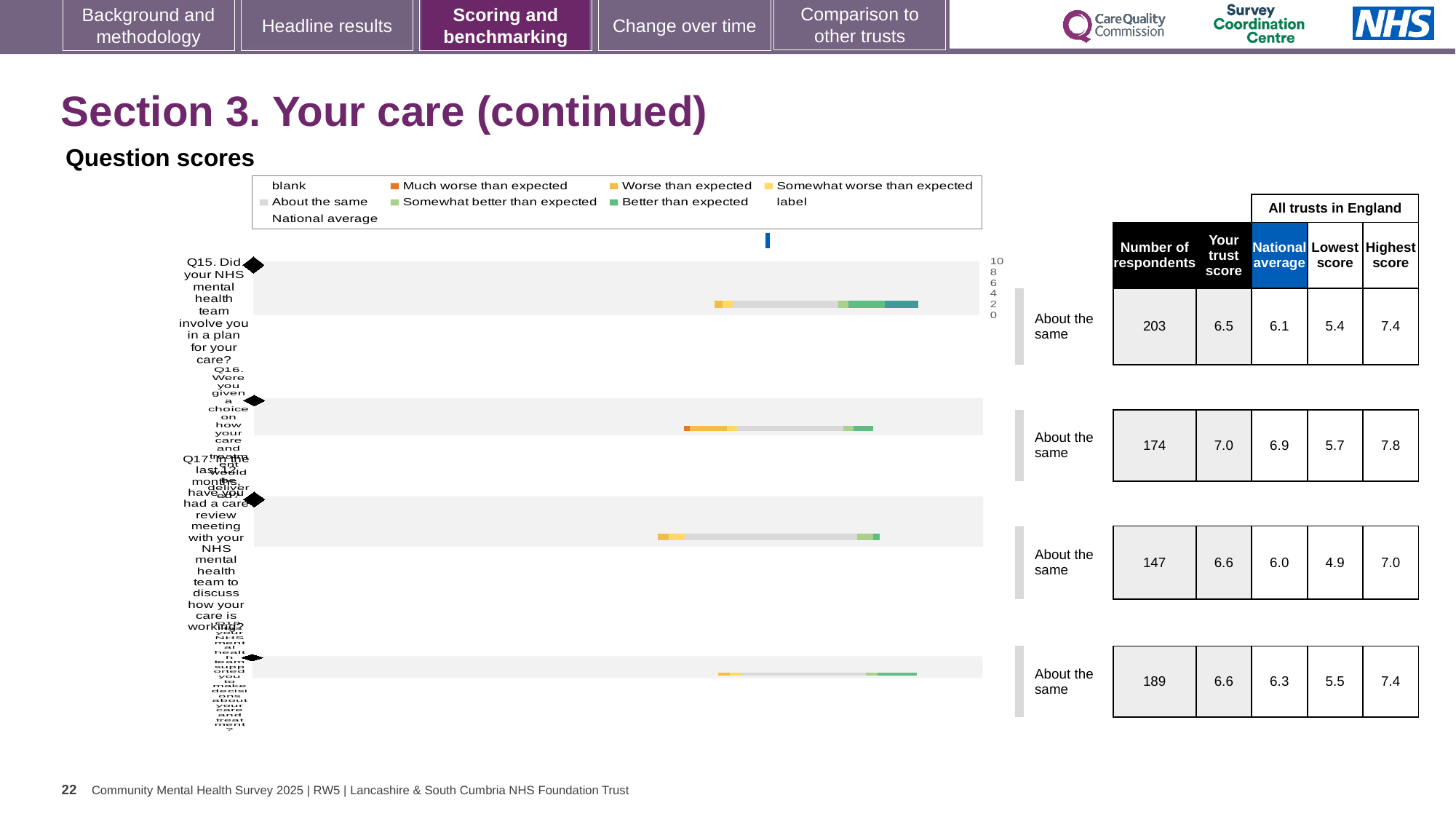
In the table beside the chart, which question has the highest 'Your trust score'? Q16 In the table beside the chart, how many respondents are listed for Q15? 203 In the legend of the question scores chart, what colour represents 'Better than expected'? green In the table beside the chart, what is the trust score for Q16? 7.0 In the table beside the chart, is the trust score for Q18 higher or lower than the national average for Q18? higher How many questions (categories) are plotted in the question scores chart? 4 In the table beside the chart, what is the difference between the trust score and the national average for Q15? 0.4 What kind of chart is used to show the question scores on this slide? bar chart In the table beside the chart, what is the lowest score for Q17? 4.9 In the legend of the question scores chart, what colour represents 'Much worse than expected'? orange How many entries does the legend of the question scores chart list? 9 In the table beside the chart, which question has the lowest national average? Q17